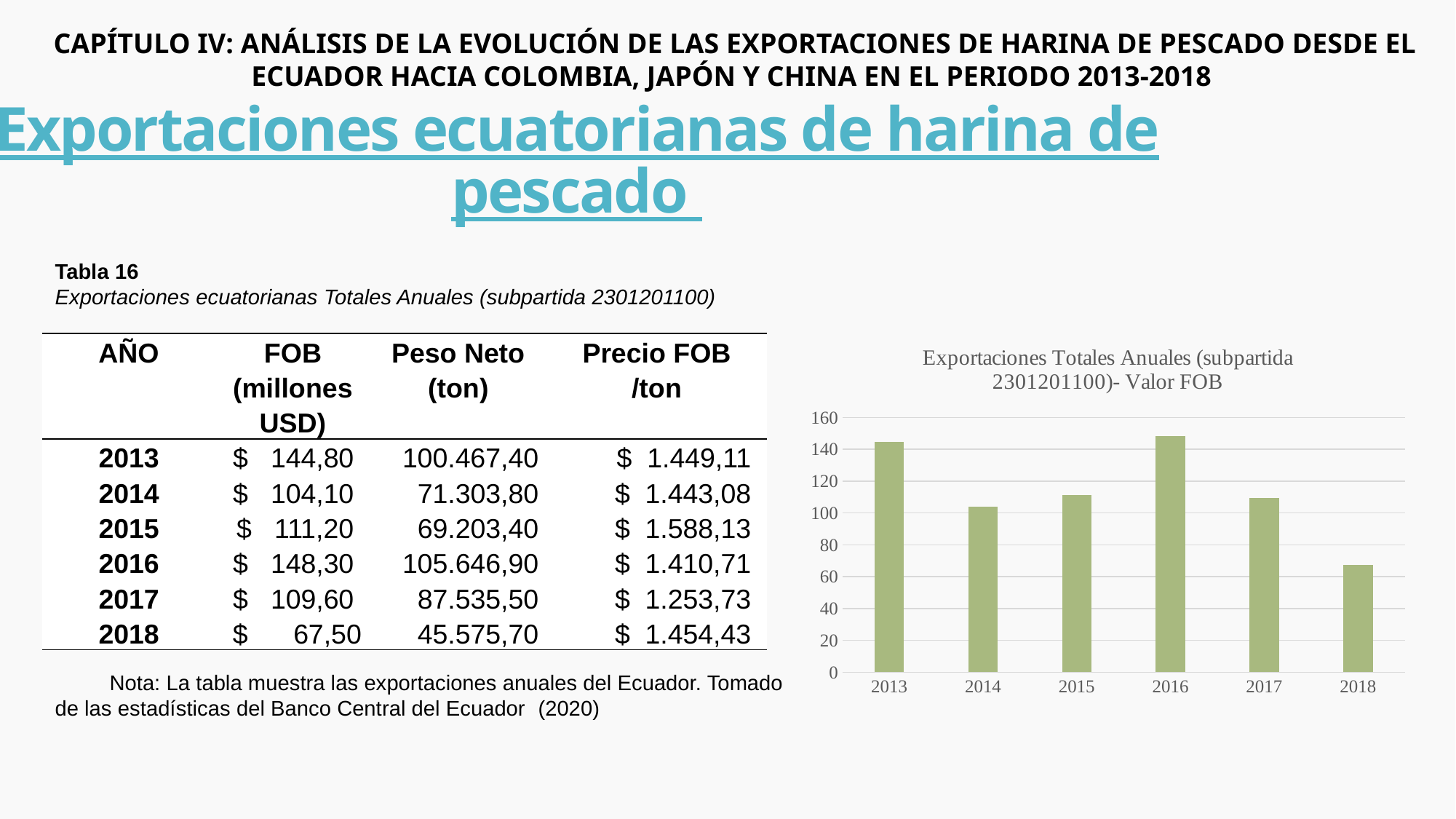
According to the slide, what is the FOB value (millones USD) plotted for 2018? $ 67,50 In the bar chart, which year has the highest FOB value? 2016 Is the bar for 2014 in the chart greater or less than 100? greater In the bar chart, which year has the larger FOB value, 2013 or 2014? 2013 According to the slide, what is the FOB value (millones USD) plotted for 2016? $ 148,30 Is the bar for 2016 in the chart greater or less than 140? greater How many years (bars) are plotted in the chart 'Exportaciones Totales Anuales (subpartida 2301201100)- Valor FOB'? 6 In the bar chart, which year has the lowest FOB value? 2018 Do the bars in the chart rise or fall from 2016 to 2018? fall Is the bar for 2018 in the chart greater or less than 80? less What type of chart is shown on the right of the slide? bar chart What is the title of the bar chart on the slide? Exportaciones Totales Anuales (subpartida 2301201100)- Valor FOB